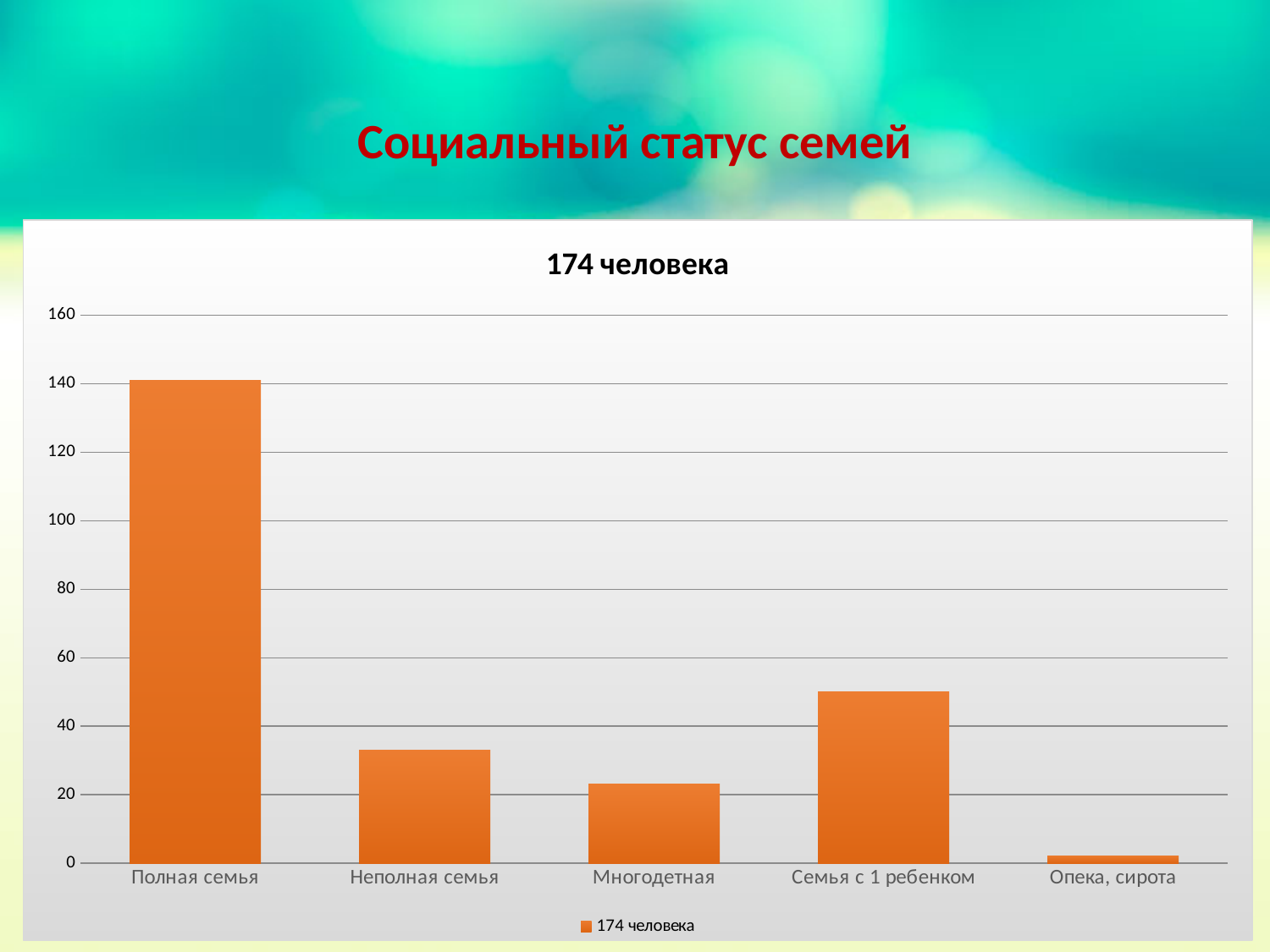
Which is larger: the value for Многодетная or the value for Неполная семья? Неполная семья What kind of chart is shown on the slide? bar chart How many categories are shown on the x axis of the chart? 5 What is the title of the chart? 174 человека Which is larger: the value for Неполная семья or the value for Семья с 1 ребенком? Семья с 1 ребенком Is the value for Семья с 1 ребенком greater or less than 40? greater Is the value for Полная семья greater or less than 120? greater Is the value for Опека, сирота greater or less than 20? less How many series does the chart legend list? 1 Which category has the lowest value in the chart? Опека, сирота Which category has the highest value in the chart? Полная семья